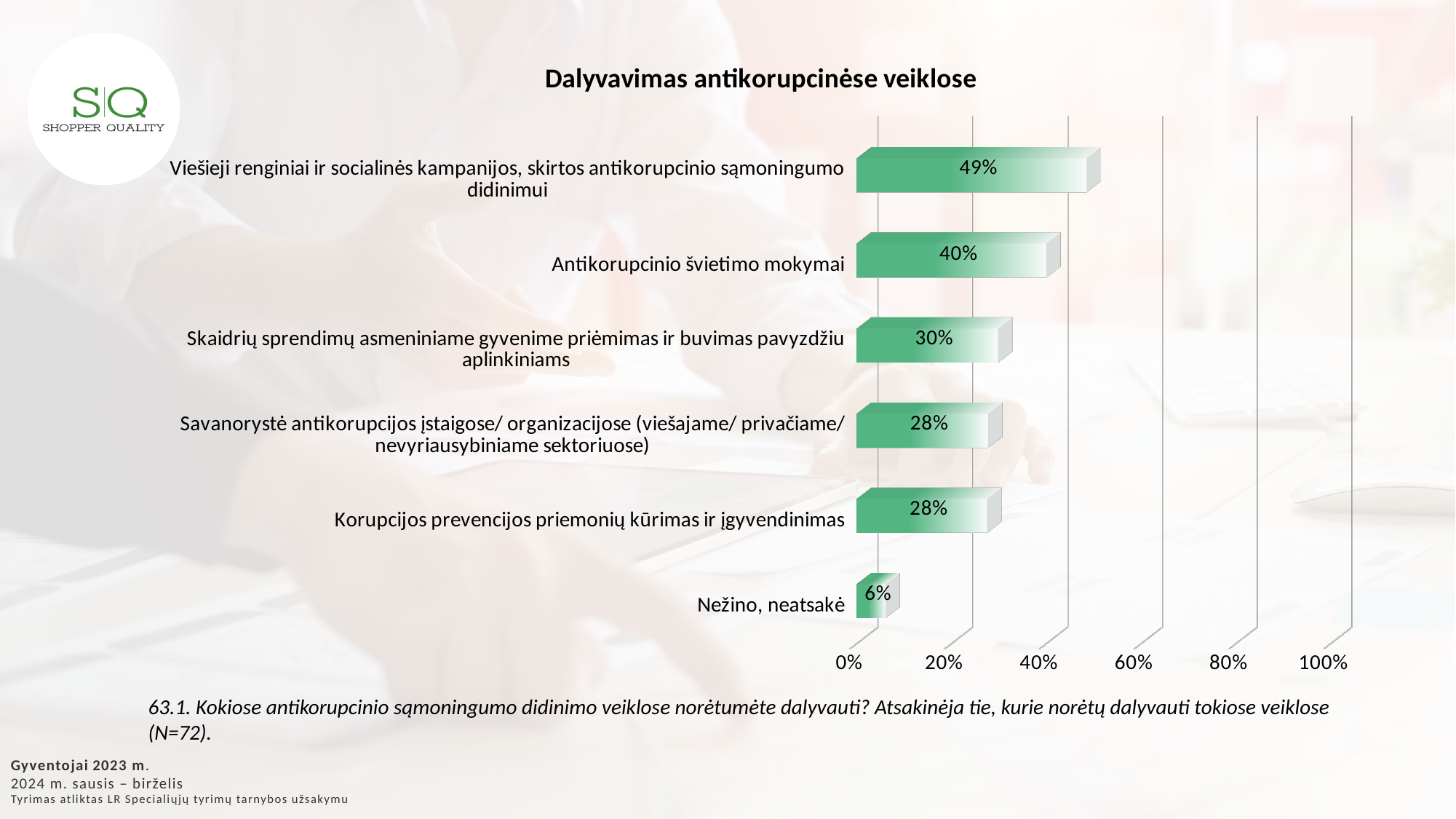
What is the difference between the values for "Viešieji renginiai ir socialinės kampanijos, skirtos antikorupcinio sąmoningumo didinimui" and "Antikorupcinio švietimo mokymai"? 9% What is the difference between the values for "Skaidrių sprendimų asmeniniame gyvenime priėmimas ir buvimas pavyzdžiu aplinkiniams" and "Nežino, neatsakė"? 24% What is the value for "Korupcijos prevencijos priemonių kūrimas ir įgyvendinimas"? 28% What is the value for "Antikorupcinio švietimo mokymai"? 40% What is the value for "Nežino, neatsakė"? 6% Is the value for "Viešieji renginiai ir socialinės kampanijos, skirtos antikorupcinio sąmoningumo didinimui" greater or less than 40%? greater How many categories are shown in the chart? 6 Which category has the lowest value? Nežino, neatsakė Which is larger: the value for "Antikorupcinio švietimo mokymai" or the value for "Skaidrių sprendimų asmeniniame gyvenime priėmimas ir buvimas pavyzdžiu aplinkiniams"? Antikorupcinio švietimo mokymai What kind of chart is shown on the slide? bar chart Which category has the highest value? Viešieji renginiai ir socialinės kampanijos, skirtos antikorupcinio sąmoningumo didinimui What is the title of the chart? Dalyvavimas antikorupcinėse veiklose